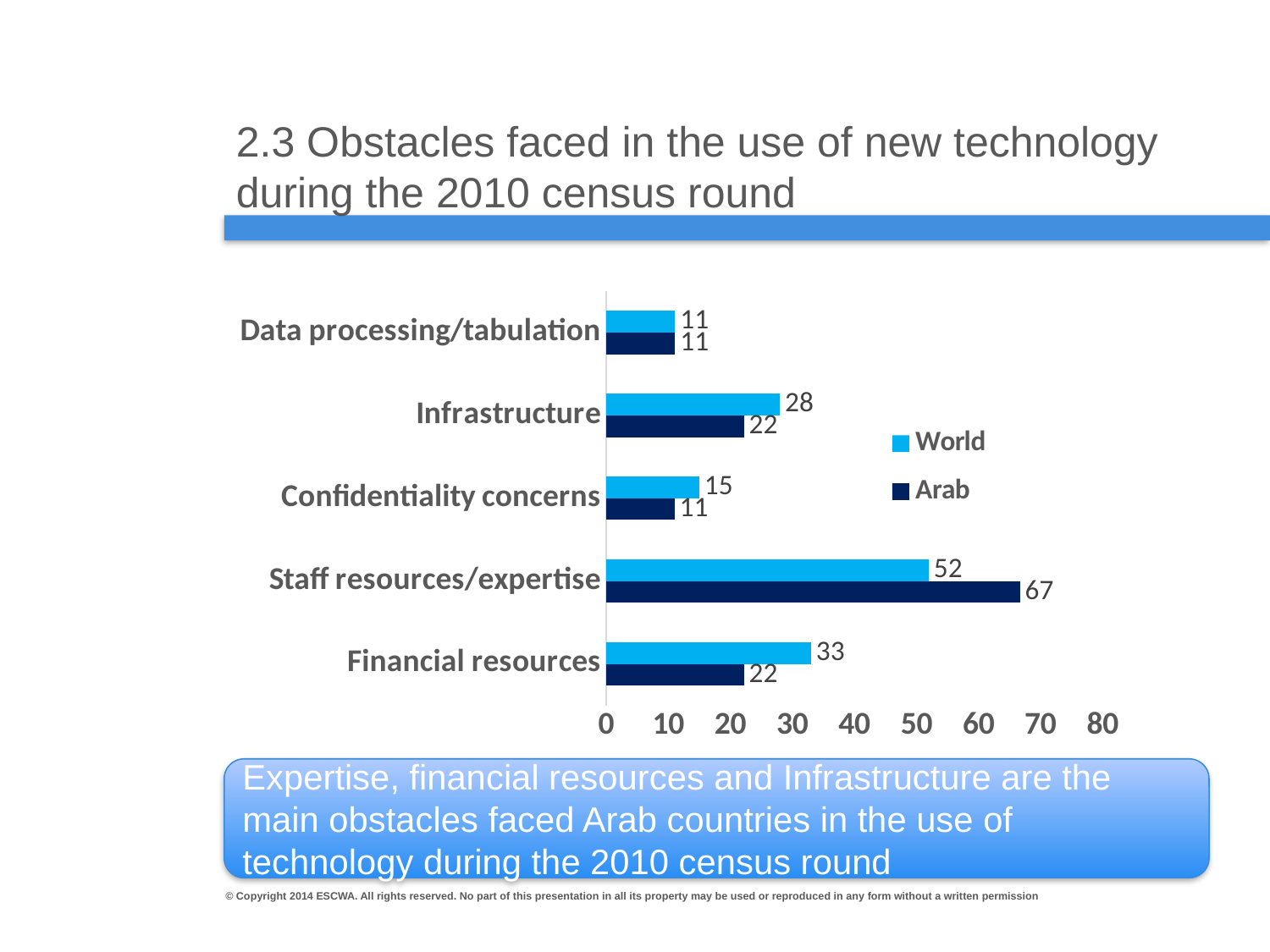
Which series is shown in dark navy blue? Arab What is the World value for Infrastructure? 28 How many categories are shown on the chart? 5 Which is larger for Financial resources, the World value or the Arab value? World What kind of chart is shown on the slide? Bar chart Which category has the highest Arab value? Staff resources/expertise What is the Arab value for Staff resources/expertise? 67 What is the difference between the Arab and World values for Staff resources/expertise? 15 What is the Arab value for Confidentiality concerns? 11 Which category has the lowest World value? Data processing/tabulation How many series does the legend list? 2 What is the World value for Financial resources? 33